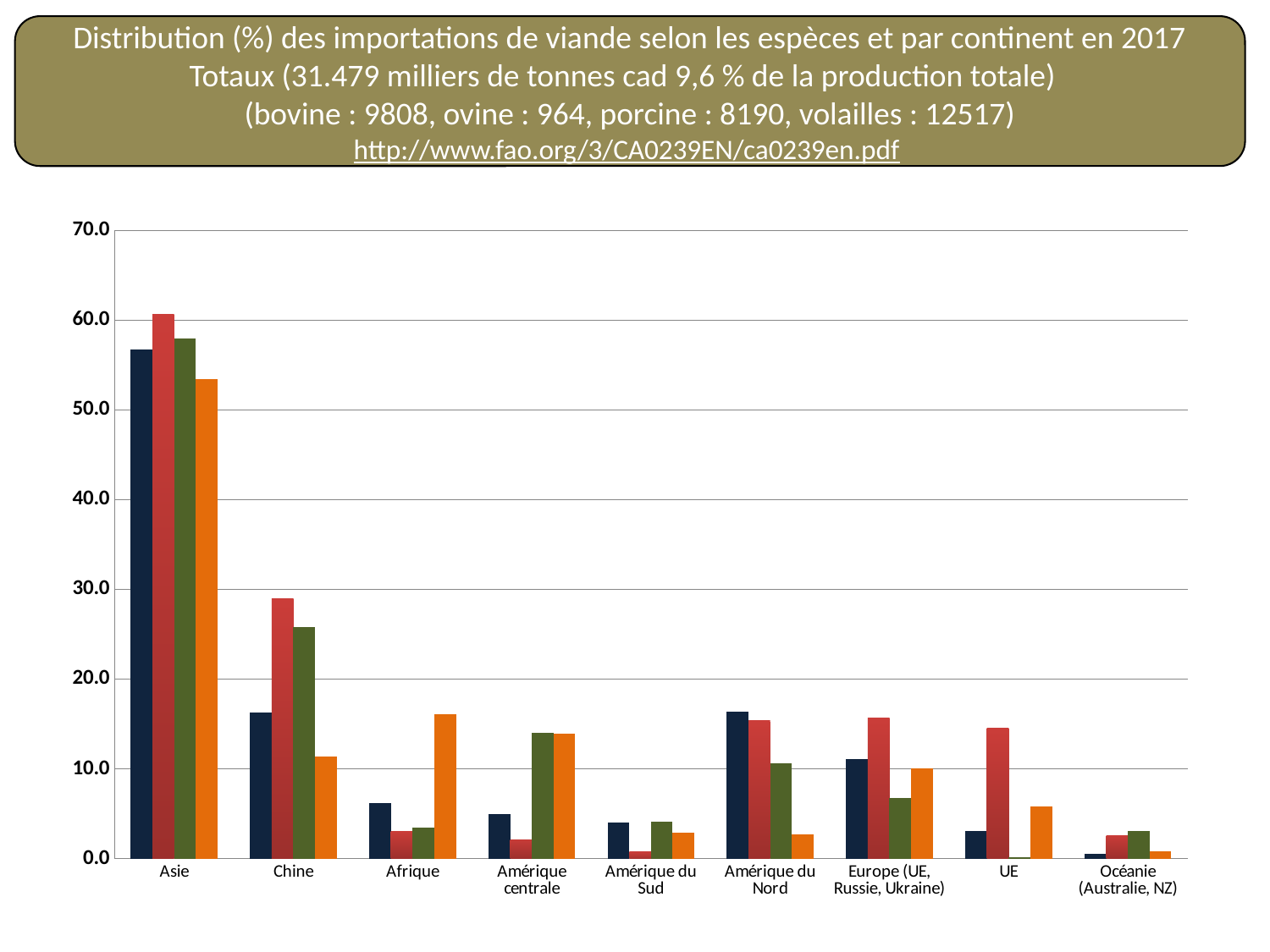
Is the value of the red bar for UE greater or less than 10? greater What kind of chart is shown on the slide? bar chart For Chine, which is larger: the red bar or the dark navy bar? the red bar Which category has the lowest bars overall? Océanie (Australie, NZ) Is the value of the orange bar for Afrique greater or less than 10? greater Which category has the highest bars overall? Asie Is the value of the dark navy bar for Asie greater or less than 50? greater How many continent/region categories are shown on the x axis? 9 What is the maximum value shown on the y axis? 70.0 For Afrique, which is larger: the orange bar or the dark navy bar? the orange bar How many bars (series) are plotted for each category? 4